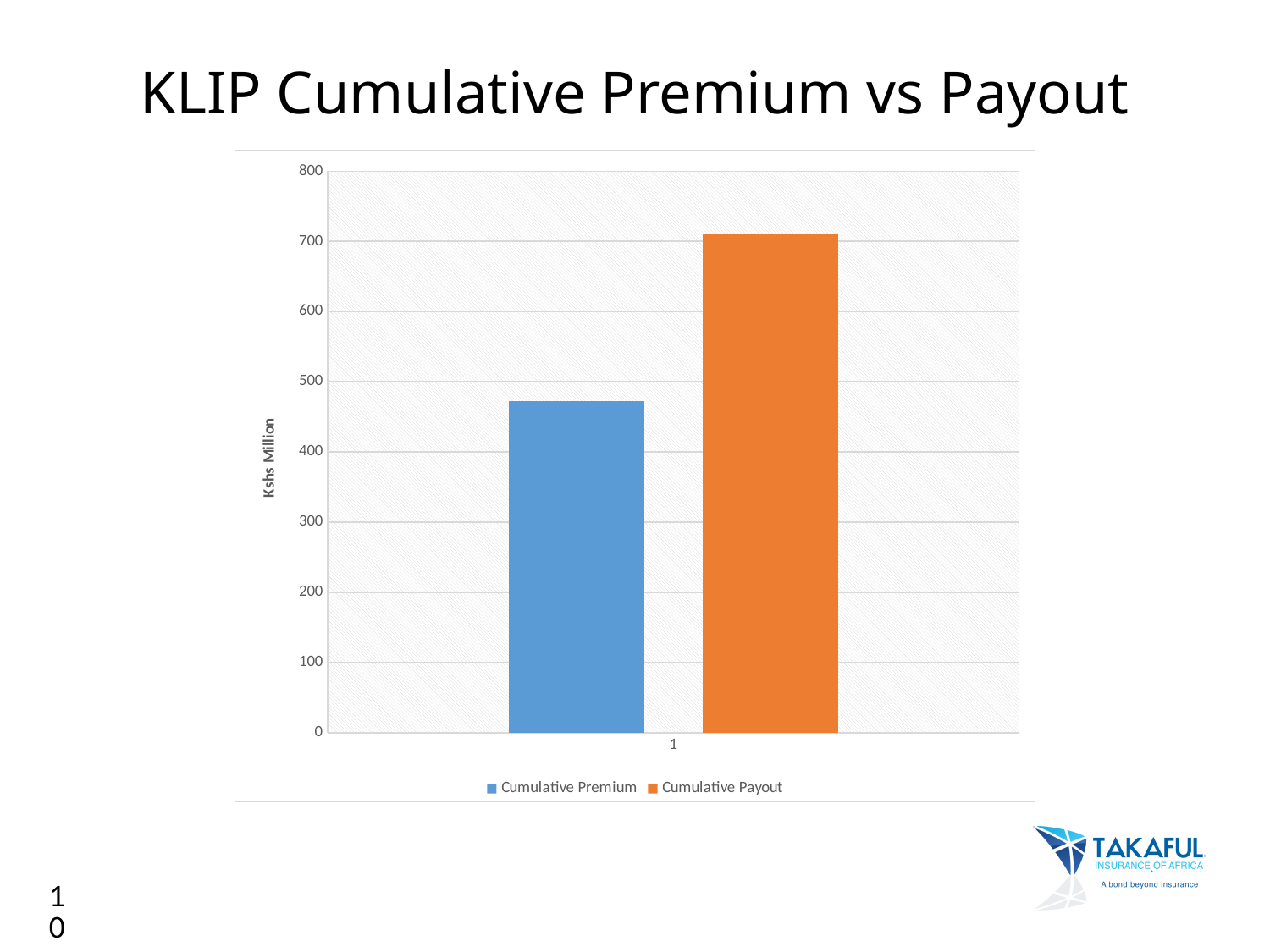
Is the value for Cumulative Payout greater or less than 800? less Which series has the lowest value? Cumulative Premium How many bars are plotted on the chart? 2 How many series does the legend list? 2 What kind of chart is shown on the slide? bar chart Which series has the highest value? Cumulative Payout Which series has the taller bar, Cumulative Premium or Cumulative Payout? Cumulative Payout Is the value for Cumulative Premium greater or less than 400? greater What is the label on the vertical axis? Kshs Million Is the value for Cumulative Payout greater or less than 700? greater What colour is the Cumulative Payout bar? orange